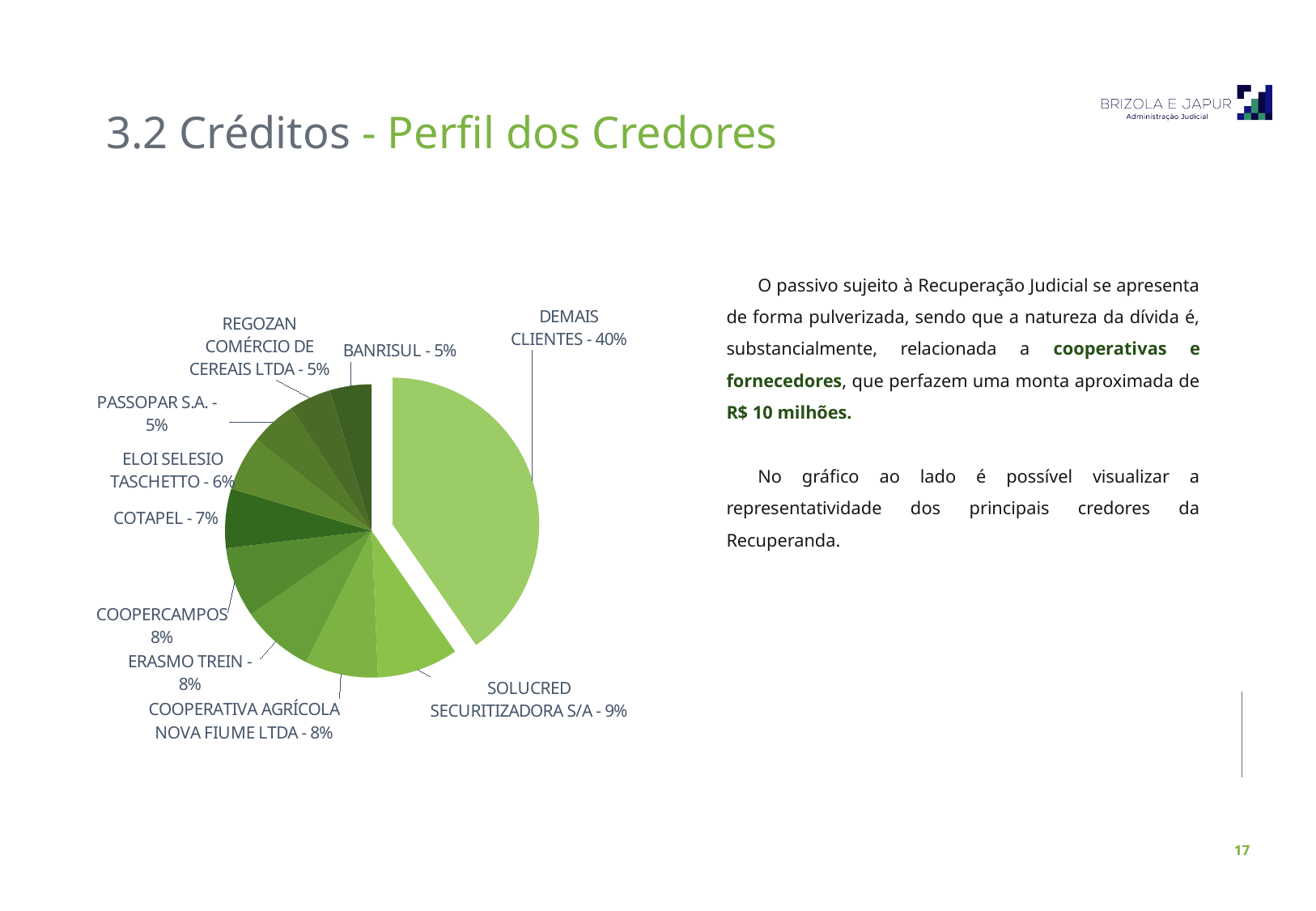
Which is larger, the share for COTAPEL or the share for PASSOPAR S.A.? COTAPEL What is the difference in percentage points between DEMAIS CLIENTES and SOLUCRED SECURITIZADORA S/A? 31 Which slice is pulled out (exploded) from the rest of the pie? DEMAIS CLIENTES What share of the pie does DEMAIS CLIENTES represent? 40% Which creditor has the largest slice of the pie? DEMAIS CLIENTES What percentage is shown for BANRISUL? 5% How many slices does the pie chart have? 10 What percentage is shown for ELOI SELESIO TASCHETTO? 6% What percentage is shown for SOLUCRED SECURITIZADORA S/A? 9% What is the difference in percentage points between COOPERCAMPOS and ELOI SELESIO TASCHETTO? 2 What percentage is shown for COTAPEL? 7% What type of chart is shown on the slide? Pie chart